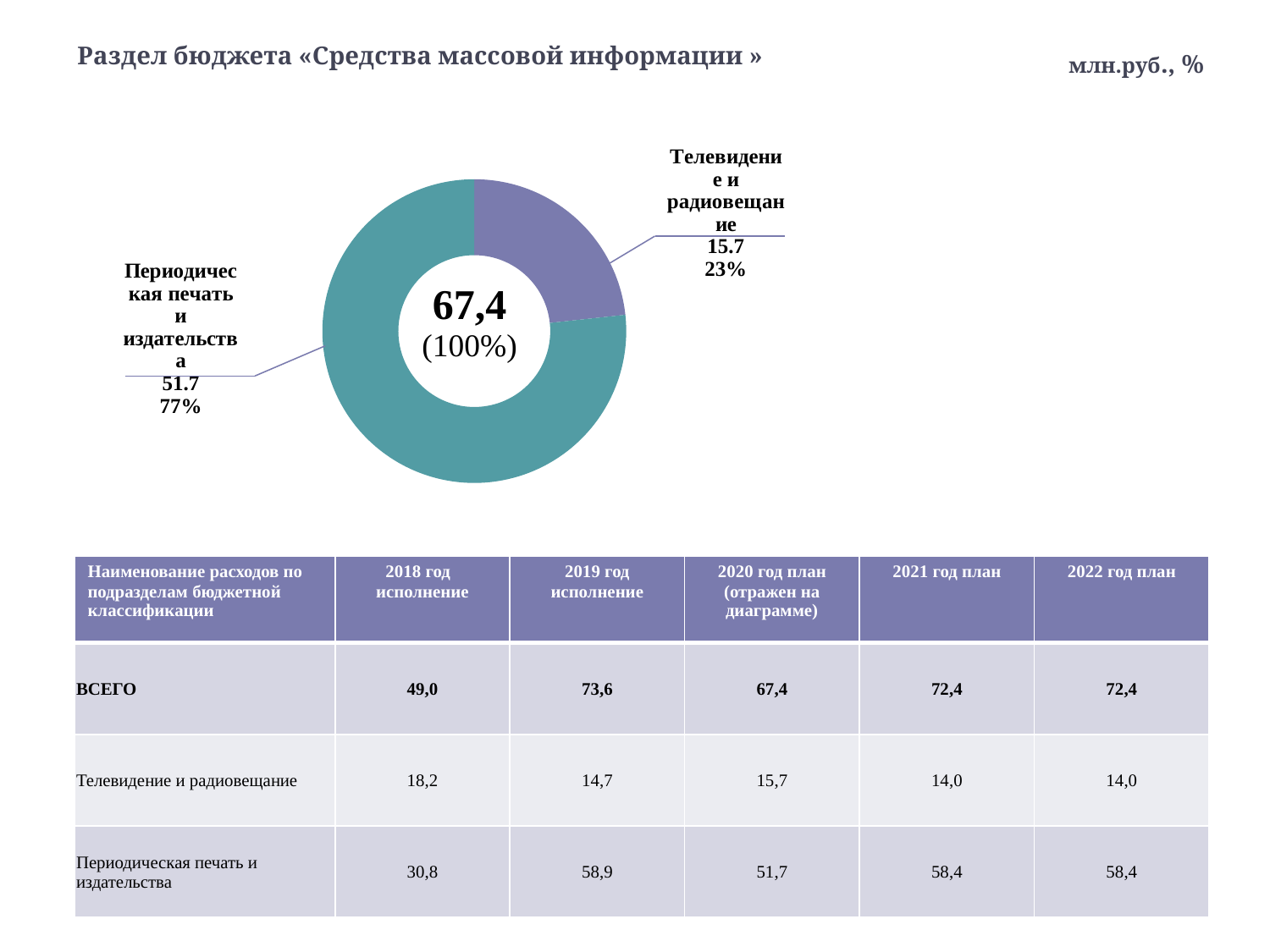
What is the difference between the values for «Периодическая печать и издательства» and «Телевидение и радиовещание» in the chart? 36.0 How many slices does the chart have? 2 What total value is shown in the centre of the chart? 67,4 (100%) What is the title of the slide containing the chart? Раздел бюджета «Средства массовой информации » What share of the chart does «Периодическая печать и издательства» represent? 77% What share of the chart does «Телевидение и радиовещание» represent? 23% What kind of chart is shown on the slide? Doughnut (pie) chart Which is larger in the chart: «Телевидение и радиовещание» or «Периодическая печать и издательства»? Периодическая печать и издательства What is the value shown for «Телевидение и радиовещание» in the chart? 15.7 Which slice of the chart is the largest? Периодическая печать и издательства Which slice of the chart is the smallest? Телевидение и радиовещание What is the value shown for «Периодическая печать и издательства» in the chart? 51.7